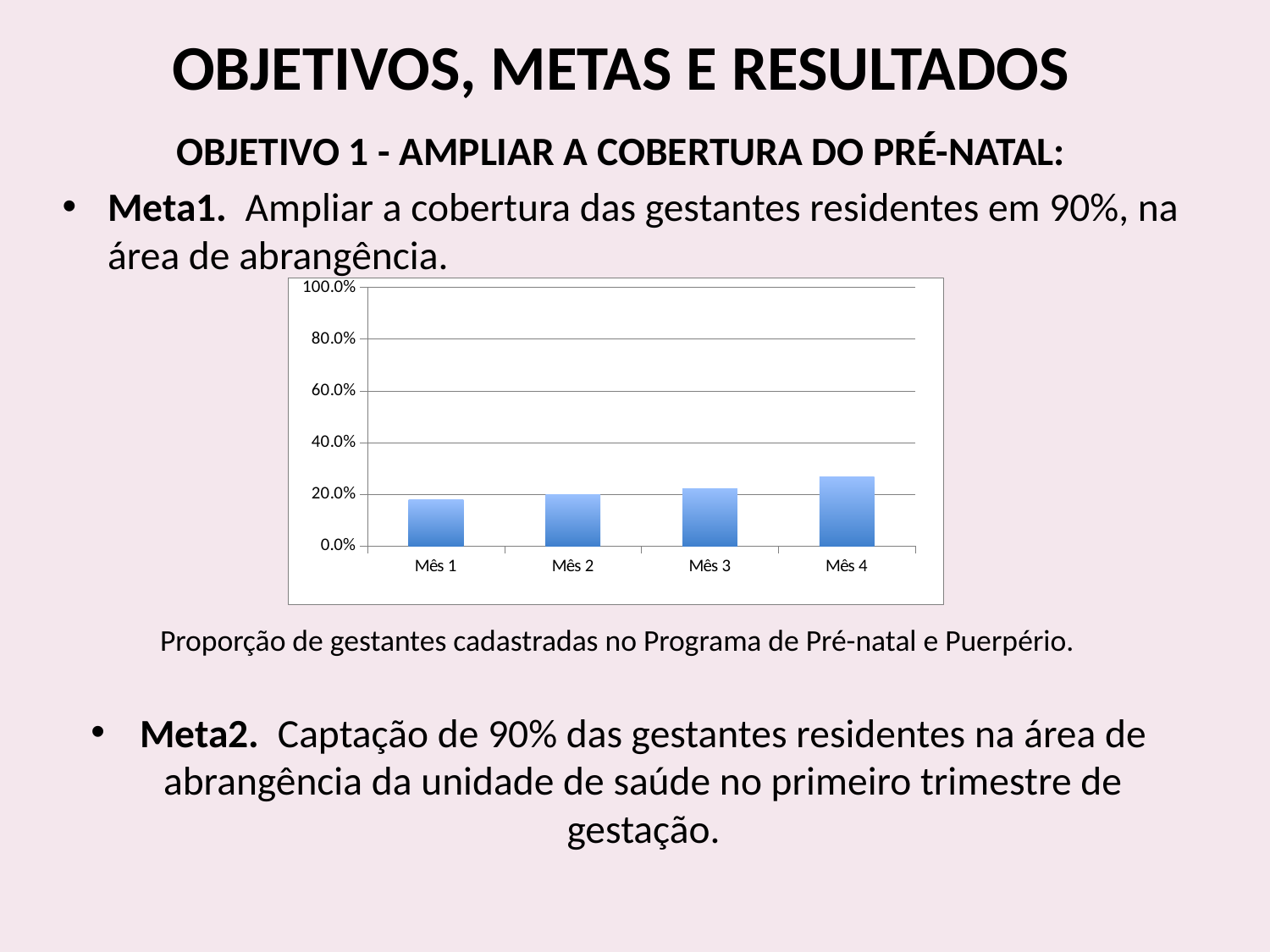
What does the caption below the chart say the chart shows? Proporção de gestantes cadastradas no Programa de Pré-natal e Puerpério. Is the value for Mês 4 greater or less than 40.0%? less Is the value for Mês 1 greater or less than 20.0%? less What kind of chart is shown on the slide? bar chart Which is larger, the value for Mês 4 or the value for Mês 1? Mês 4 Is the value for Mês 3 greater or less than 40.0%? less Do the values rise or fall from Mês 1 to Mês 4? rise What is the highest value shown on the chart's vertical axis? 100.0% Which is larger, the value for Mês 3 or the value for Mês 1? Mês 3 How many months (categories) are plotted on the chart? 4 Which month has the highest value on the chart? Mês 4